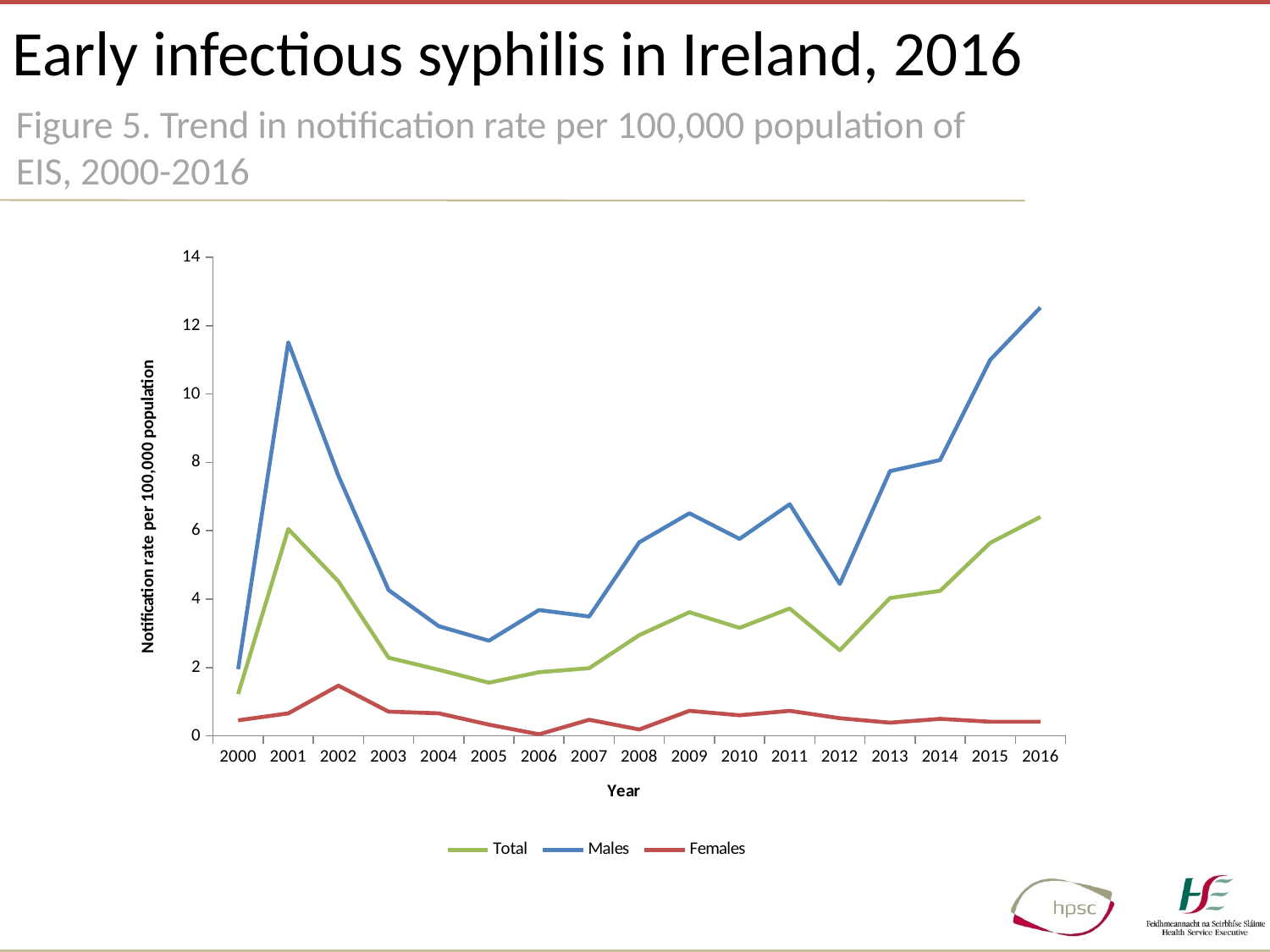
In which year is the Females notification rate highest? 2002 In which year is the Males notification rate lowest? 2000 What kind of chart is shown on the slide? line chart Does the Males notification rate rise or fall from 2012 to 2016? rise How many series does the legend list? 3 Is the Males value for 2016 greater or less than 12? greater In which year is the Males notification rate highest? 2016 What is the label on the y axis? Notification rate per 100,000 population Which is larger, the Males value for 2001 or the Males value for 2011? 2001 Is the Males value for 2005 greater or less than 4? less How many years are plotted along the x axis? 17 Is the Females value for 2002 greater or less than 2? less